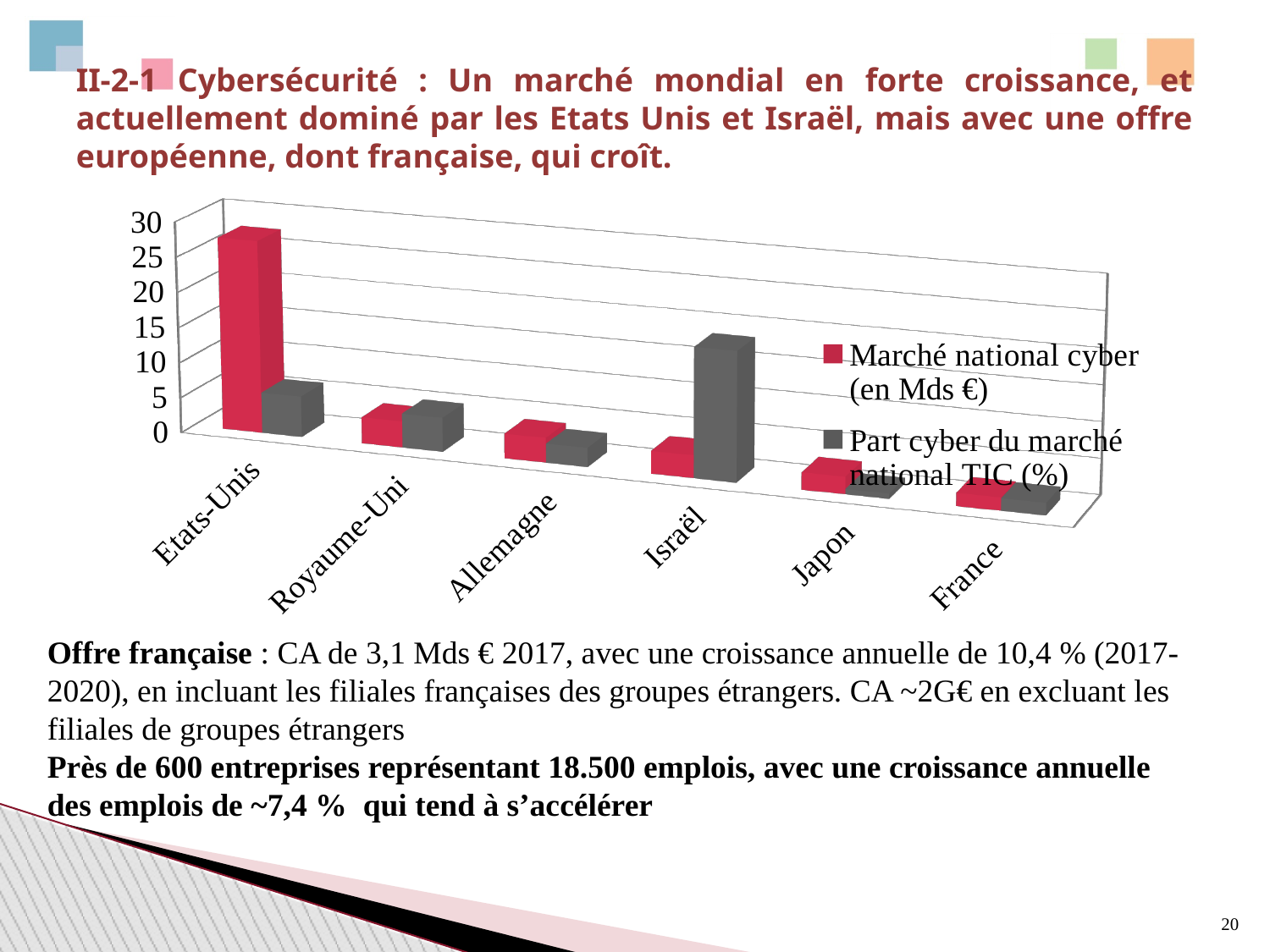
Which country has the highest value for 'Marché national cyber (en Mds €)'? Etats-Unis Is the 'Marché national cyber (en Mds €)' value for Etats-Unis greater or less than 20? greater How many series does the chart's legend list? 2 Which has the larger 'Marché national cyber (en Mds €)' value, Etats-Unis or Royaume-Uni? Etats-Unis Which series is shown in red in the chart? Marché national cyber (en Mds €) Is the 'Part cyber du marché national TIC (%)' value for Israël greater or less than 10? greater Which has the larger 'Part cyber du marché national TIC (%)' value, Israël or Allemagne? Israël Which country has the highest value for 'Part cyber du marché national TIC (%)'? Israël Is the 'Marché national cyber (en Mds €)' value for Royaume-Uni greater or less than 10? less Which series is shown in grey in the chart? Part cyber du marché national TIC (%) What kind of chart is shown on the slide? bar chart How many countries are shown on the x axis of the chart? 6